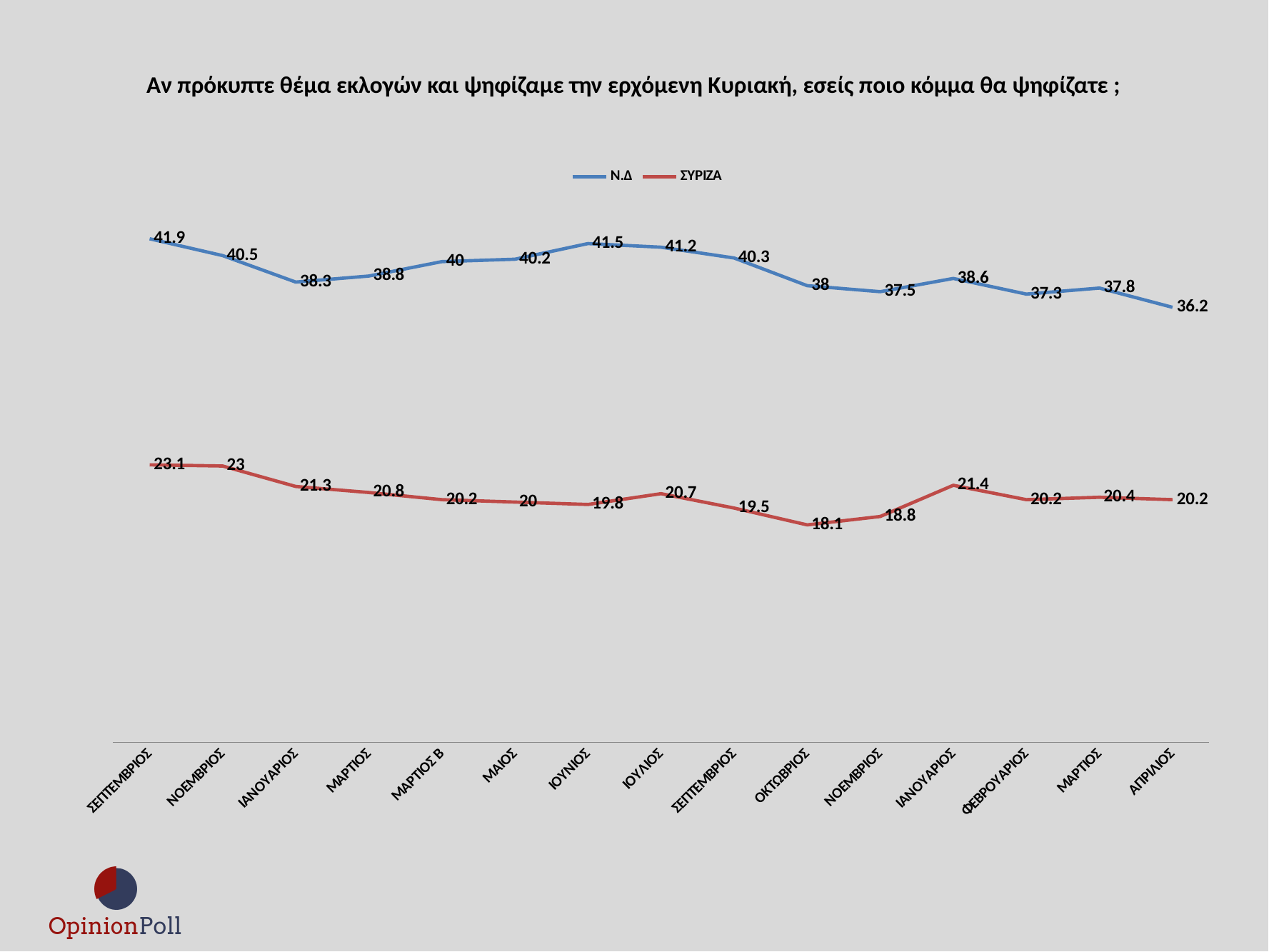
What kind of chart is shown on the slide? Line chart What is the value for Ν.Δ at ΑΠΡΙΛΙΟΣ? 36.2 What is the value for Ν.Δ at ΙΟΥΝΙΟΣ? 41.5 What is the value for ΣΥΡΙΖΑ at ΦΕΒΡΟΥΑΡΙΟΣ? 20.2 How many series does the legend list? 2 Which series has the higher value at ΜΑΙΟΣ, Ν.Δ or ΣΥΡΙΖΑ? Ν.Δ At which point on the x axis does Ν.Δ reach its lowest value? ΑΠΡΙΛΙΟΣ How many data points does each line have along the x axis? 15 What is the value for ΣΥΡΙΖΑ at ΟΚΤΩΒΡΙΟΣ? 18.1 What is the difference between Ν.Δ and ΣΥΡΙΖΑ at ΑΠΡΙΛΙΟΣ? 16 What is the highest value shown for ΣΥΡΙΖΑ? 23.1 At which point on the x axis does ΣΥΡΙΖΑ reach its lowest value? ΟΚΤΩΒΡΙΟΣ